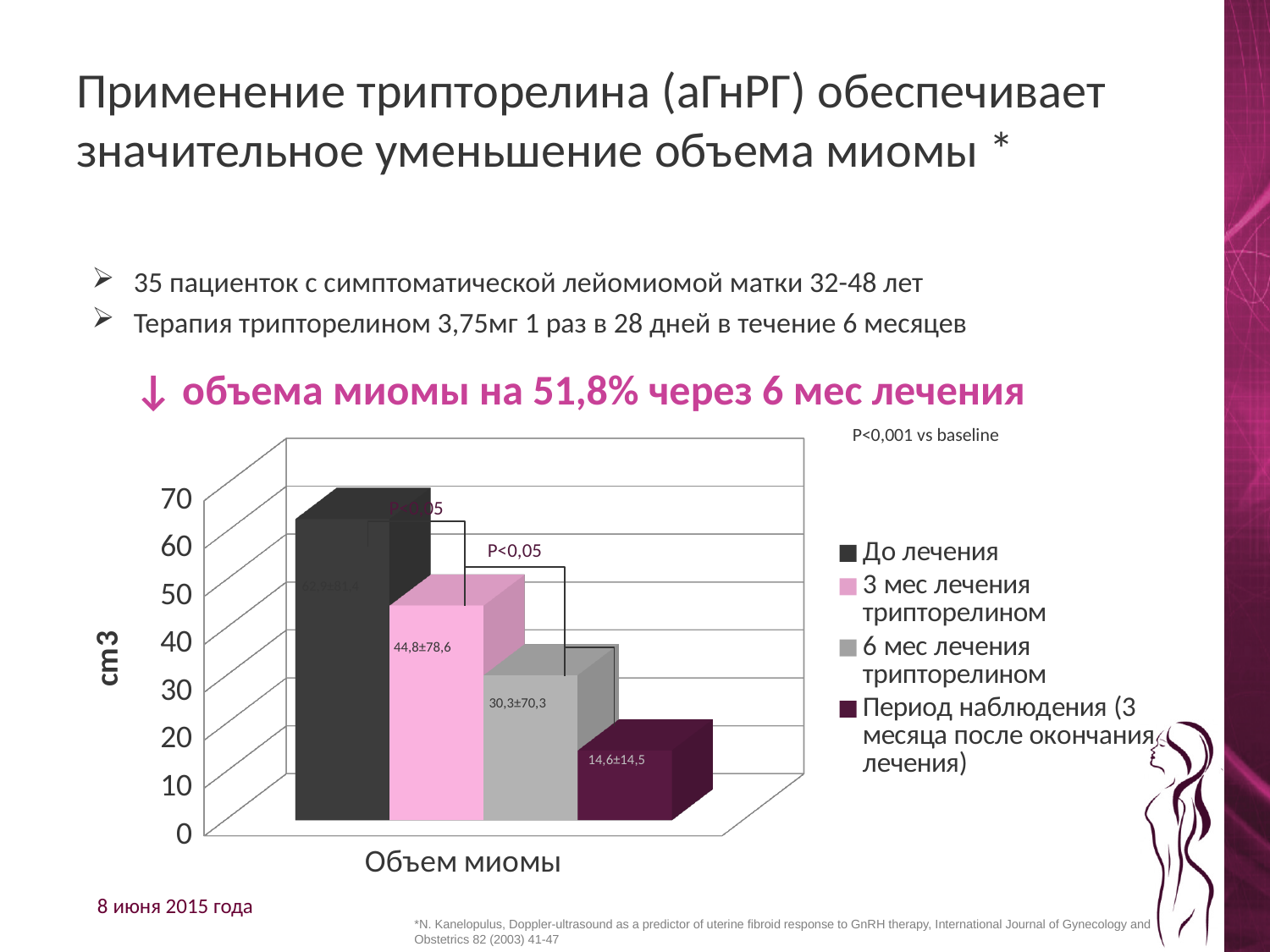
Which bar is taller: "3 мес лечения трипторелином" or "6 мес лечения трипторелином"? 3 мес лечения трипторелином Is the value for "Период наблюдения (3 месяца после окончания лечения)" greater or less than 20? less What value is labelled on the bar for "Период наблюдения (3 месяца после окончания лечения)"? 14,6±14,5 What value is labelled on the bar for "6 мес лечения трипторелином"? 30,3±70,3 How many series does the chart legend list? 4 What value is labelled on the bar for "3 мес лечения трипторелином"? 44,8±78,6 Which series has the shortest bar in the chart? Период наблюдения (3 месяца после окончания лечения) Is the value for "До лечения" greater or less than 50? greater Do the bar values rise or fall from "До лечения" through to "Период наблюдения"? fall What is the label on the vertical axis of the chart? cm3 Which series has the tallest bar in the chart? До лечения What kind of chart is shown on the slide? bar chart